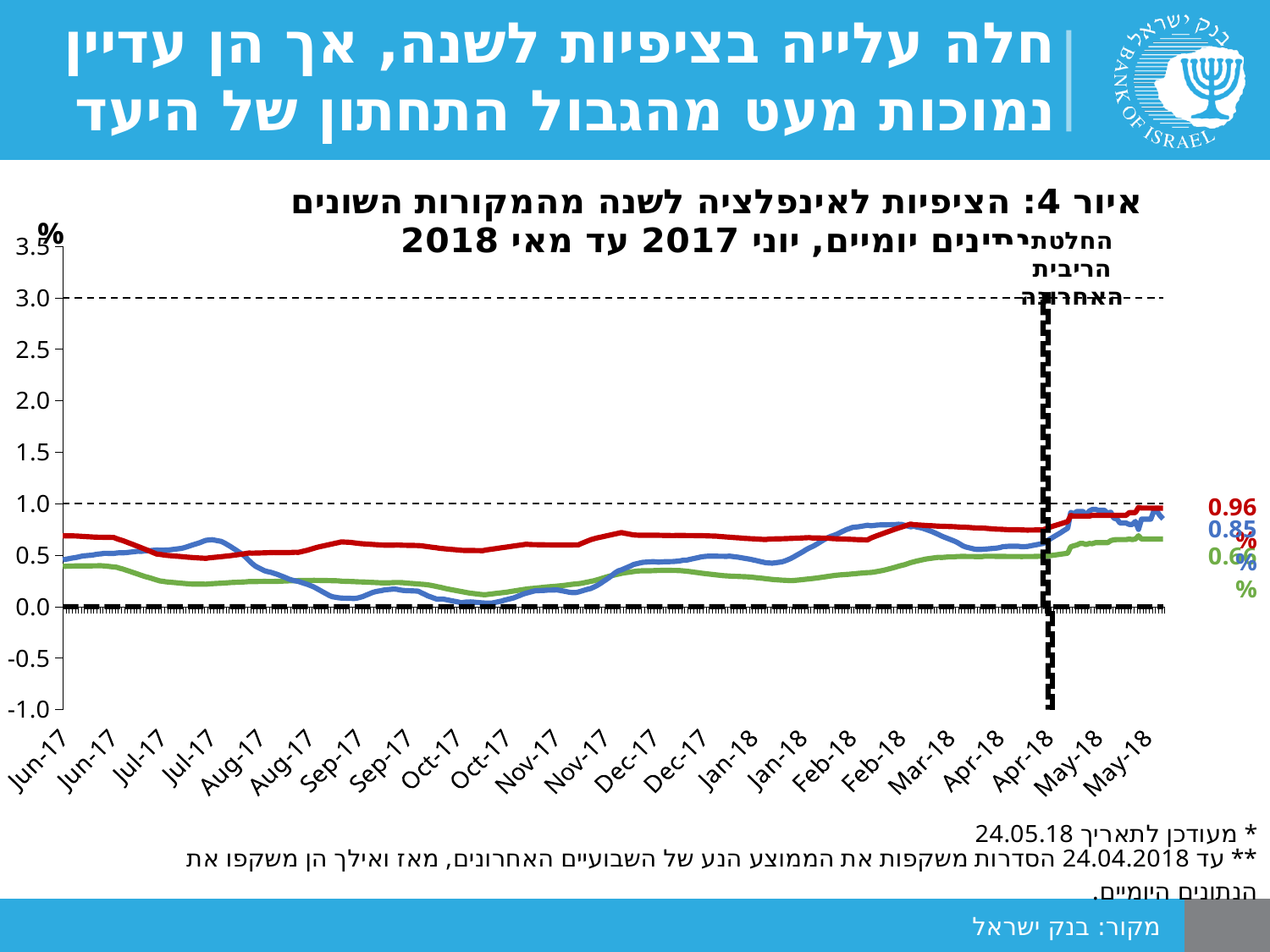
What is the final value labelled at the end of the red line? 0.96% Which line ends at the lowest value in May 2018? the green line Is the value of the green line in Sep-17 greater or less than 0.5? less Does the green line rise or fall between Jan-18 and May-18? rises How many lines are plotted on the chart? 3 What kind of chart is shown on the slide? line chart Which line ends at the highest value in May 2018? the red line At what two levels are the horizontal dashed lines drawn on the chart? 1.0 and 3.0 What is the difference between the final values of the red line (0.96) and the blue line (0.85)? 0.11 What is the final value labelled at the end of the blue line? 0.85% Is the final value of the red line greater or less than 1.0? less